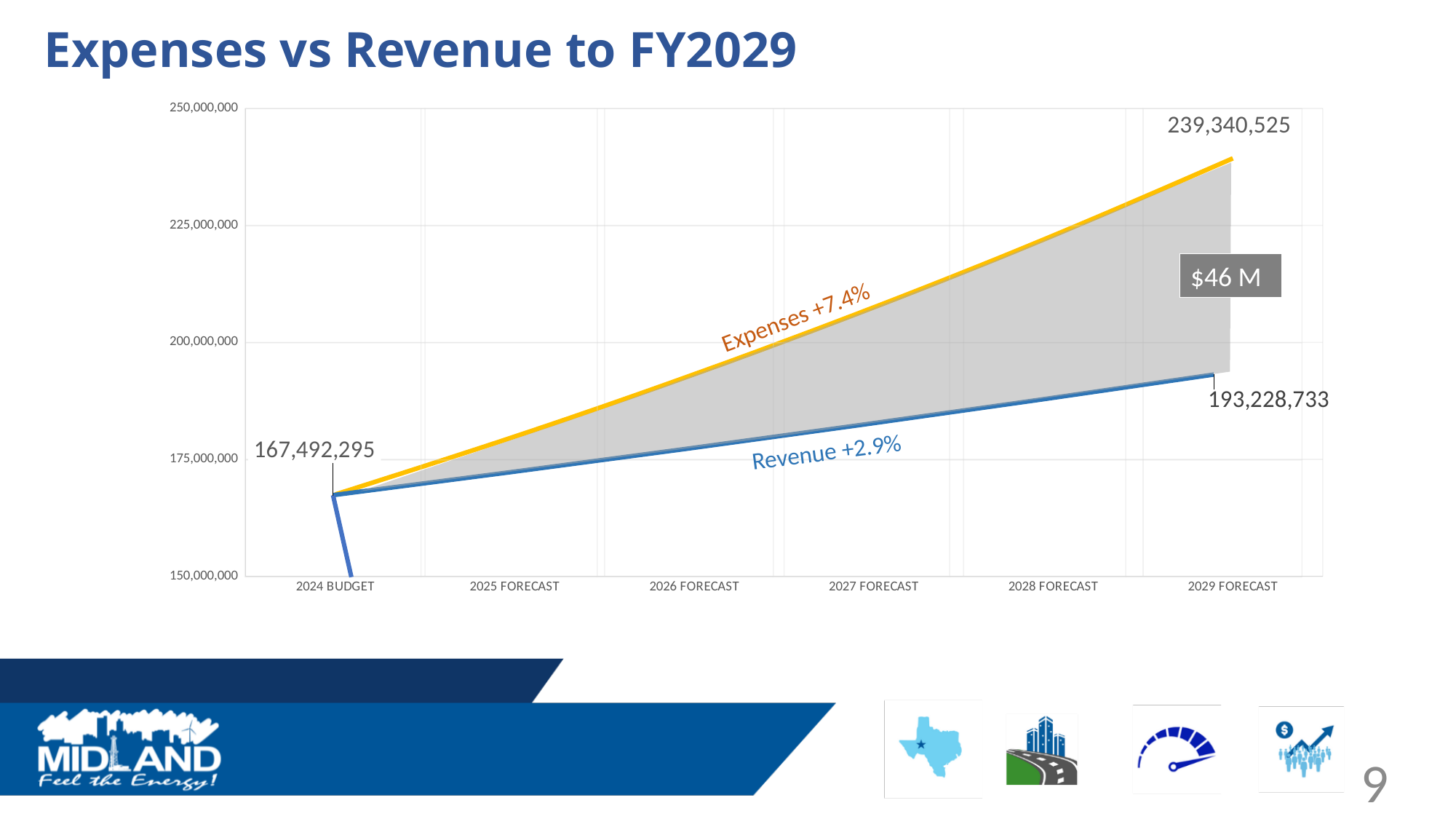
What gap amount is printed in the grey box between the two lines? $46 M What kind of chart is shown on the slide? Line chart Is the value for Expenses at 2028 FORECAST greater or less than 200,000,000? greater What annual growth rate is labelled on the Expenses line? +7.4% Is the value for Revenue at 2027 FORECAST greater or less than 200,000,000? less What is the value shown for 2024 BUDGET, where the Expenses and Revenue lines start? 167,492,295 What is the value of Expenses at 2029 FORECAST? 239,340,525 What is the difference between Expenses and Revenue at 2029 FORECAST? 46,111,792 What is the value of Revenue at 2029 FORECAST? 193,228,733 How many categories are shown on the x axis? 6 Which is larger at 2029 FORECAST, Expenses or Revenue? Expenses Do the Expenses values rise or fall from 2024 BUDGET to 2029 FORECAST? Rise